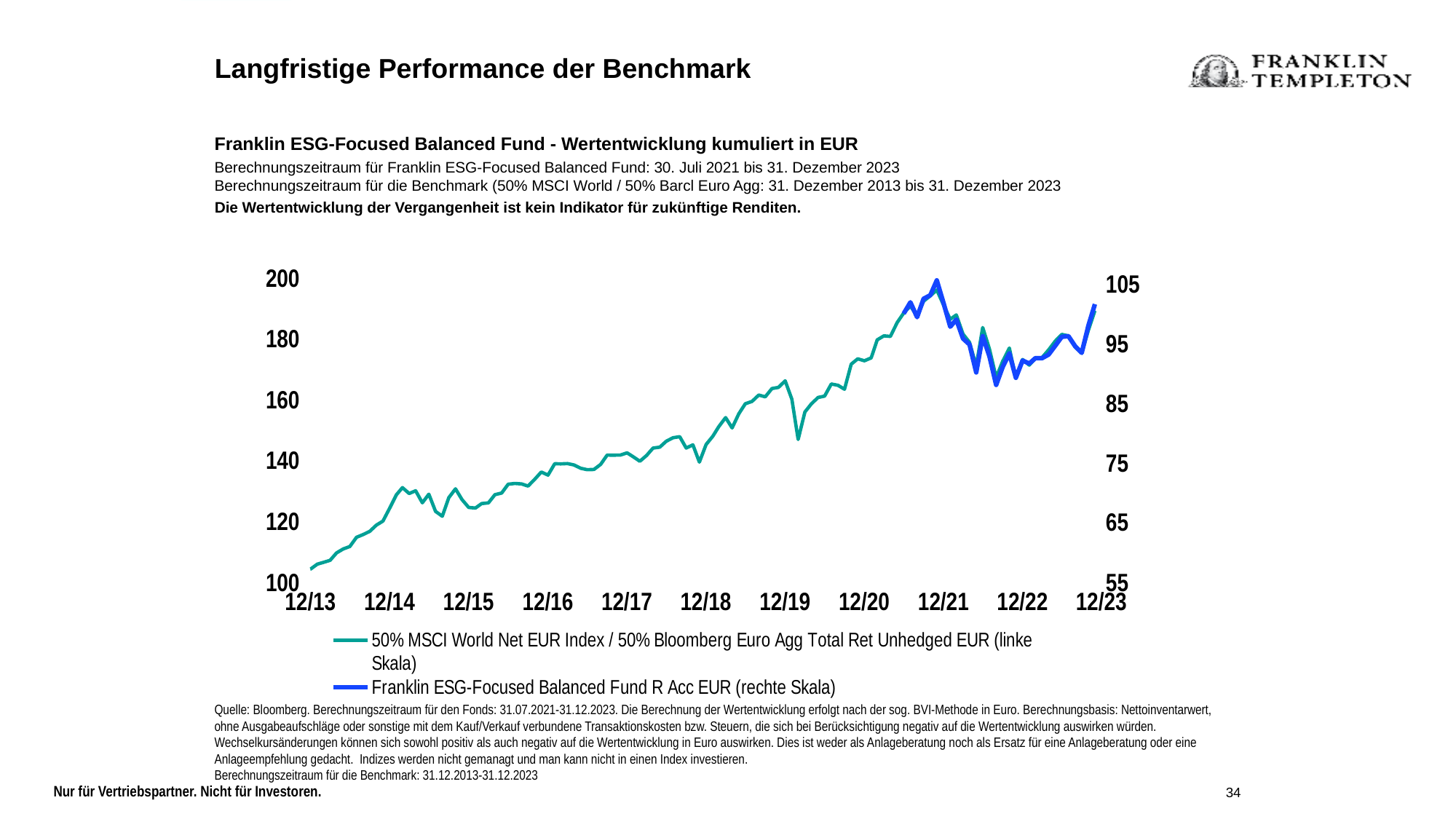
What kind of chart is shown on the slide? Line chart Is the Franklin ESG-Focused Balanced Fund value (rechte Skala) at 12/23 greater or less than 95? greater Is the benchmark value (linke Skala) at 12/13 greater or less than 120? less Which series is plotted on the right scale (rechte Skala)? Franklin ESG-Focused Balanced Fund R Acc EUR Is the benchmark value (linke Skala) at 12/21 greater or less than 180? greater How many series does the chart legend list? 2 How many date labels are shown along the x axis of the chart? 11 Does the benchmark line (linke Skala) rise or fall overall from 12/13 to 12/23? Rise What colour is the line for the 50% MSCI World Net EUR Index / 50% Bloomberg Euro Agg Total Ret Unhedged EUR series? Green